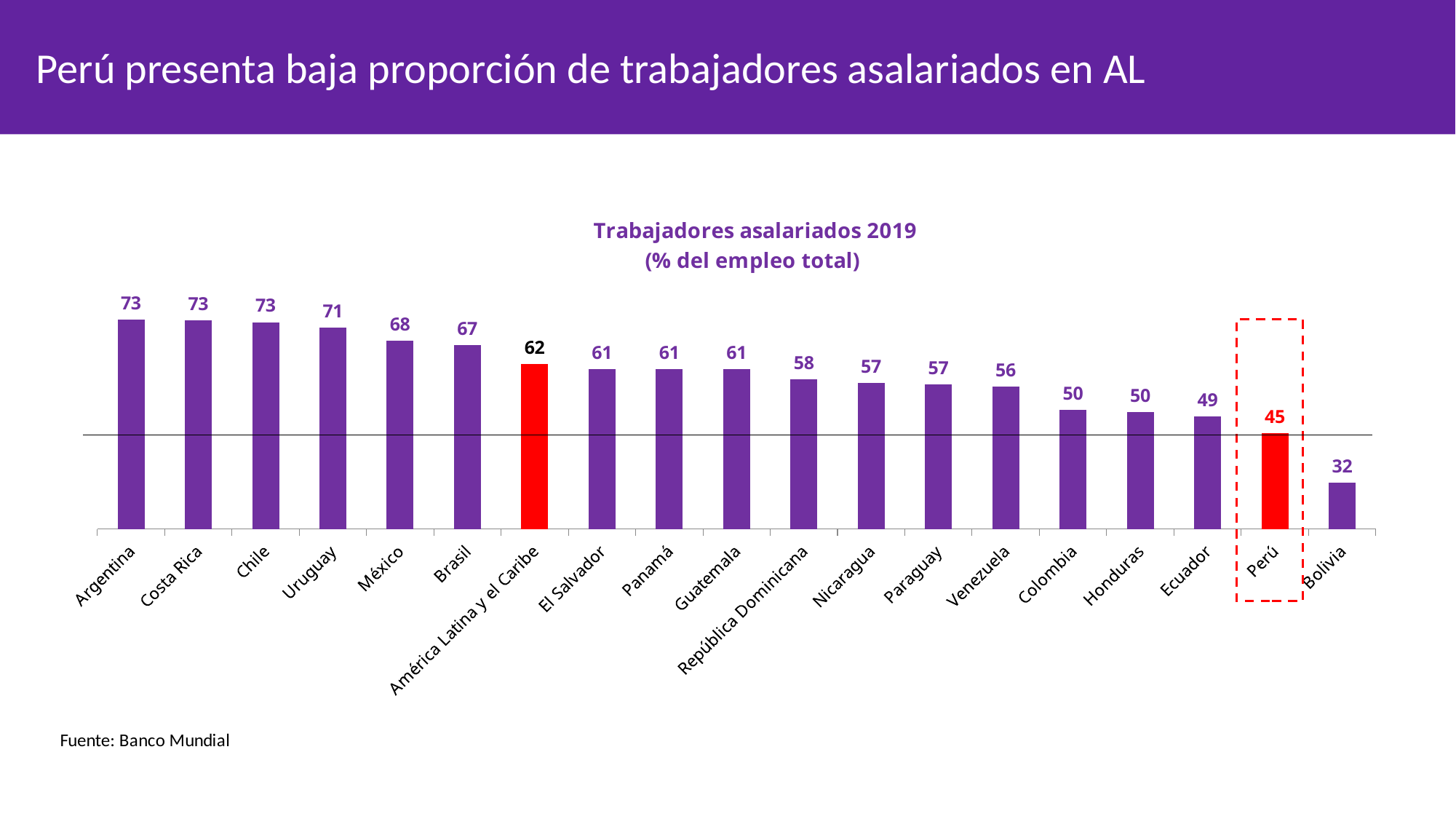
What kind of chart is shown on the slide? Bar chart What is the value for Perú? 45 What is the value for América Latina y el Caribe? 62 Which is larger, the value for Ecuador or the value for Perú? Ecuador What is the difference between the values for América Latina y el Caribe and Perú? 17 What is the difference between the values for Argentina and Bolivia? 41 What is the value for Uruguay? 71 What is the title of the chart? Trabajadores asalariados 2019 (% del empleo total) Which category has the lowest value? Bolivia How many categories are shown on the x axis? 19 Which is larger, the value for México or the value for Brasil? México What is the value for Bolivia? 32